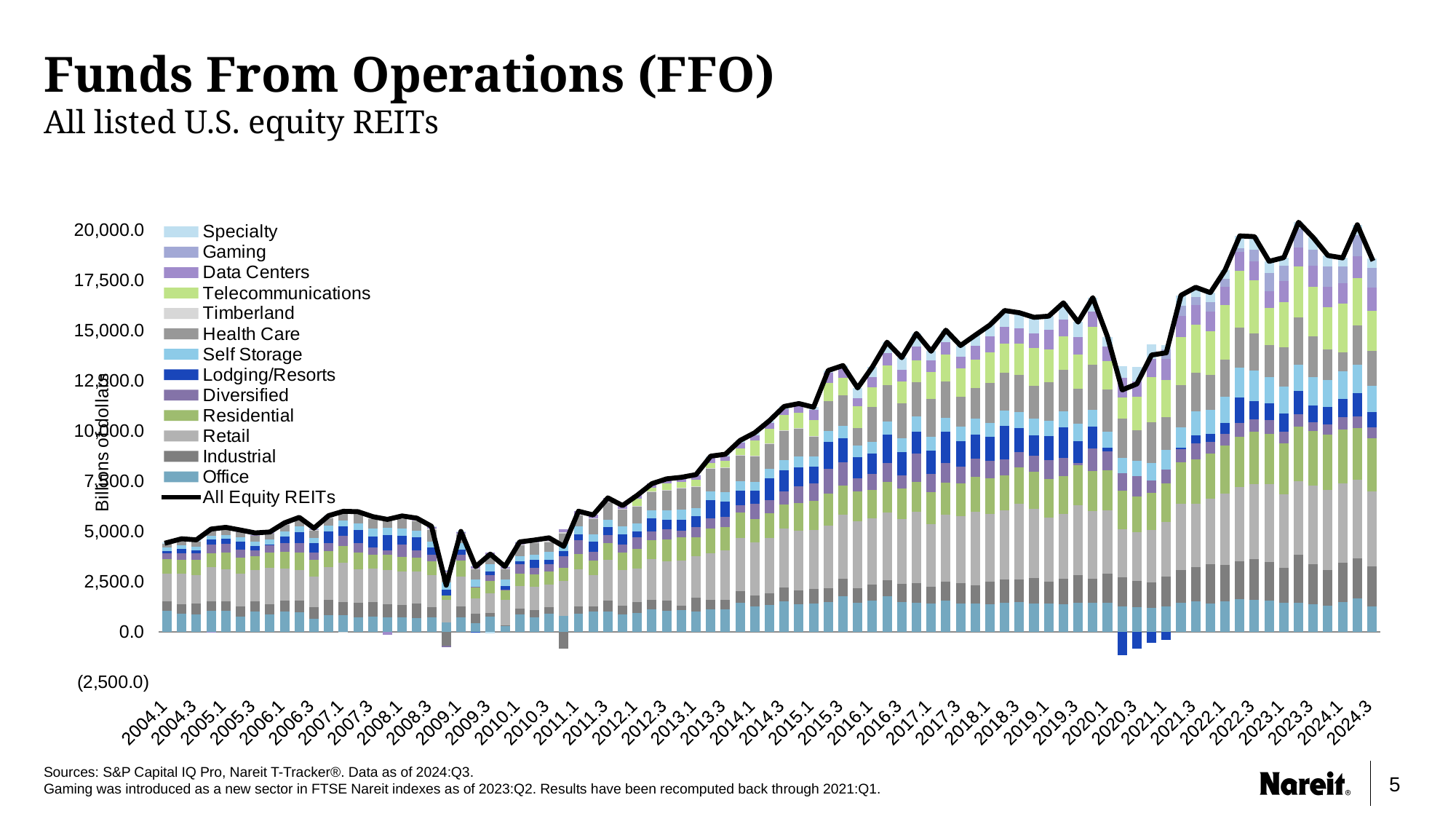
In which quarter does the All Equity REITs line reach its lowest point? 2008.4 How many entries does the legend list? 14 What is the label on the vertical axis? Billions of dollars Which sector shows negative values in the bars for 2020.3 through 2021.2? Lodging/Resorts What kind of chart is shown on the slide? Stacked bar chart with a line Does the All Equity REITs line generally rise or fall from 2004.1 to 2024.3? rise Is the All Equity REITs value for 2004.1 greater or less than 7,500.0? less Is the All Equity REITs value for 2024.3 greater or less than the value for 2004.1? greater What is the title of the chart? Funds From Operations (FFO) Is the All Equity REITs value for 2020.3 greater or less than 15,000.0? less Is the All Equity REITs value for 2023.3 greater or less than 17,500.0? greater